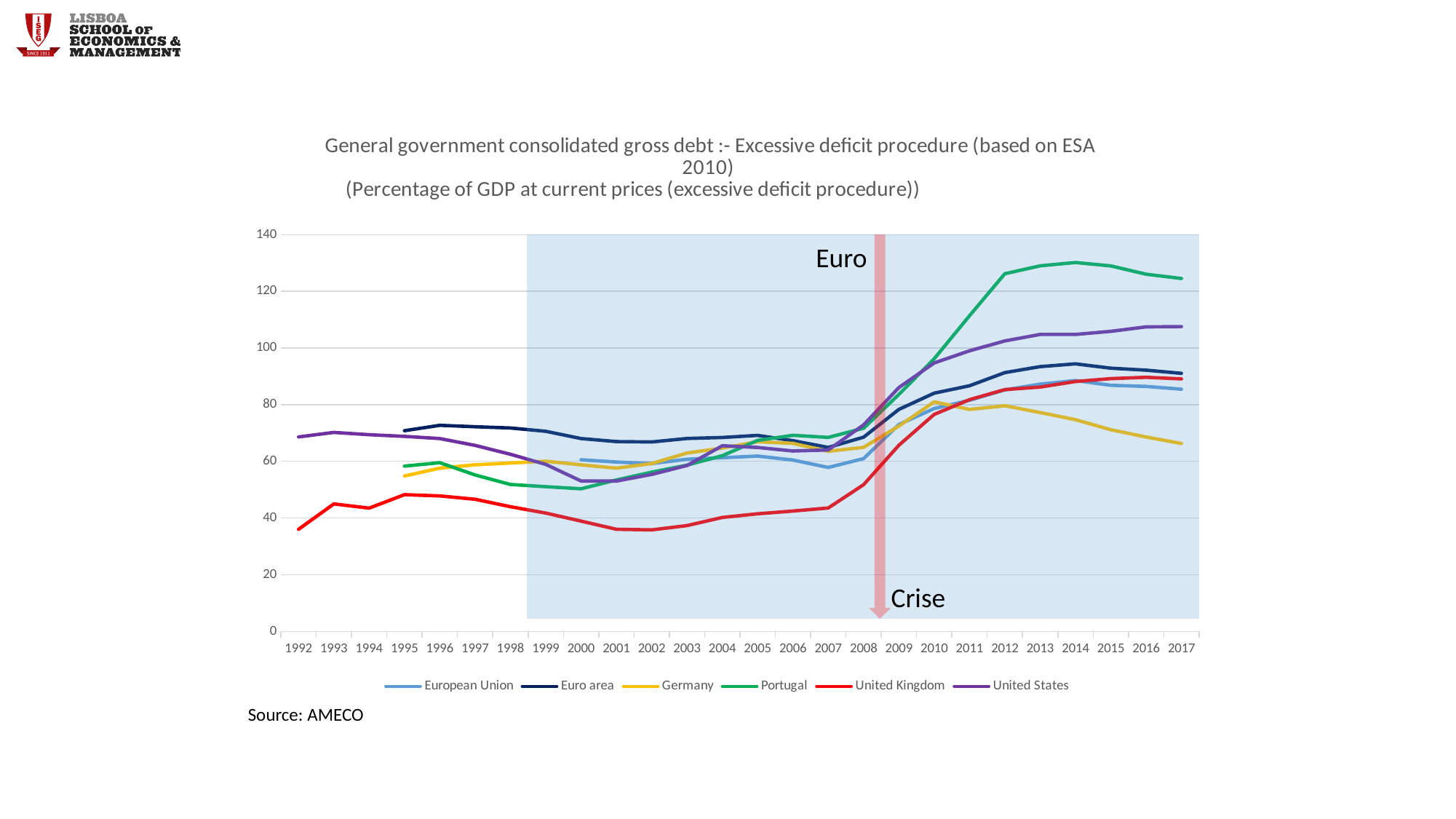
How many series does the legend list? 6 Is the value for the United States in 2017 greater or less than 100? greater What source is cited below the chart? AMECO Is the value for Portugal in 2014 greater or less than 120? greater Is the value for the United Kingdom in 2001 greater or less than 40? less How many years are shown on the x axis? 26 Which is larger in 2017, the value for Portugal or the value for the United States? Portugal Which series has the lowest value in 2017? Germany Does the value for Germany rise or fall from 2012 to 2017? fall Which series has the lowest value in 2000? United Kingdom Which series has the highest value in 2017? Portugal What kind of chart is shown on the slide? Line chart